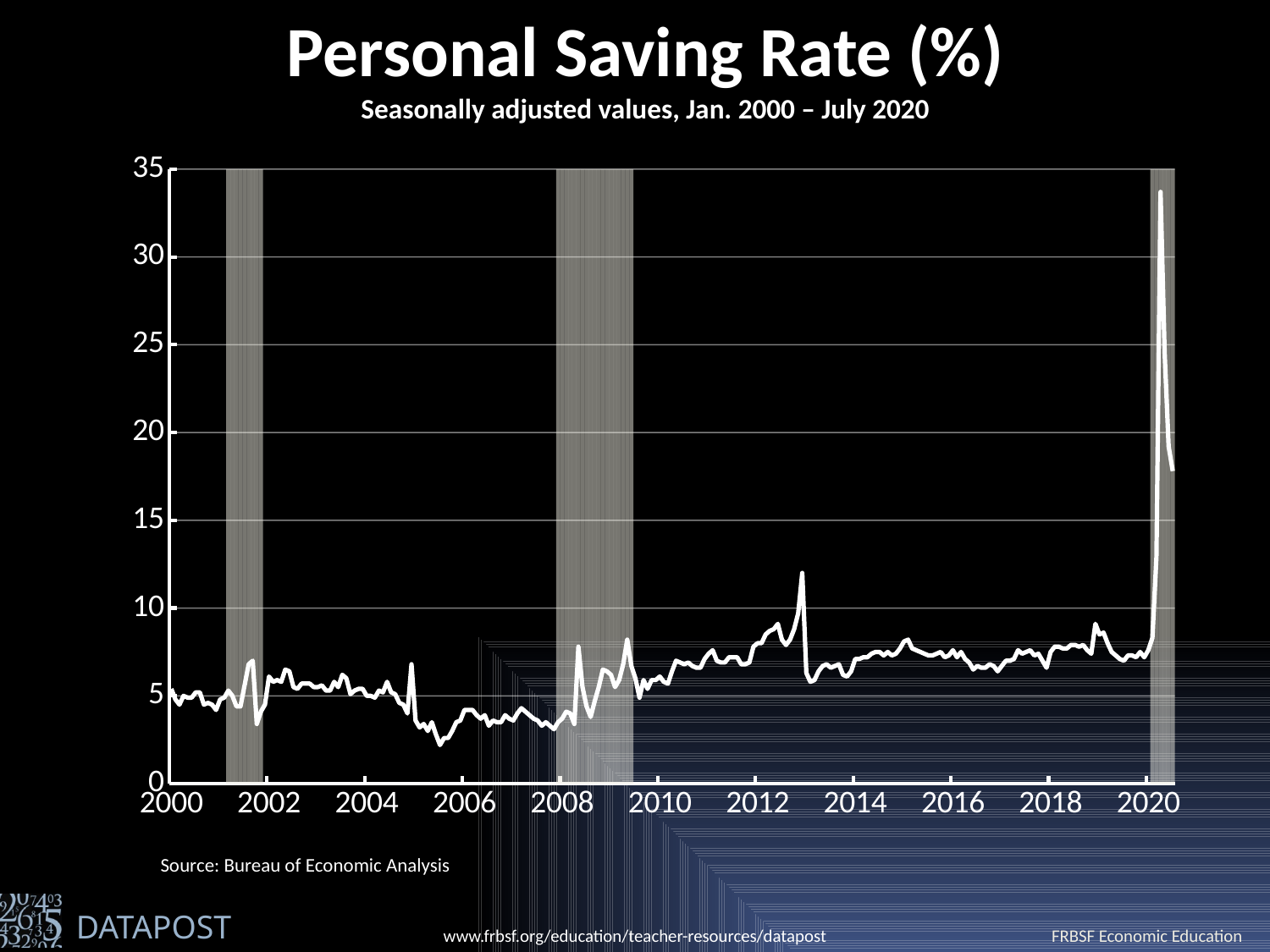
Is the personal saving rate in 2018 greater or less than 5? greater Is the personal saving rate at the start of 2000 greater or less than 10? less Does the personal saving rate rise or fall between 2005 and 2012? rise What kind of chart is shown on the slide? line chart In which year does the personal saving rate reach its highest value? 2020 What source is cited for the chart's data? Bureau of Economic Analysis Is the peak value of the personal saving rate in 2020 greater or less than 30? greater What is the title of the chart? Personal Saving Rate (%) What is the highest value shown on the y axis? 35 Which is larger, the personal saving rate at its 2020 peak or its value in 2012? 2020 peak Which is larger, the personal saving rate in 2005 or in 2012? 2012